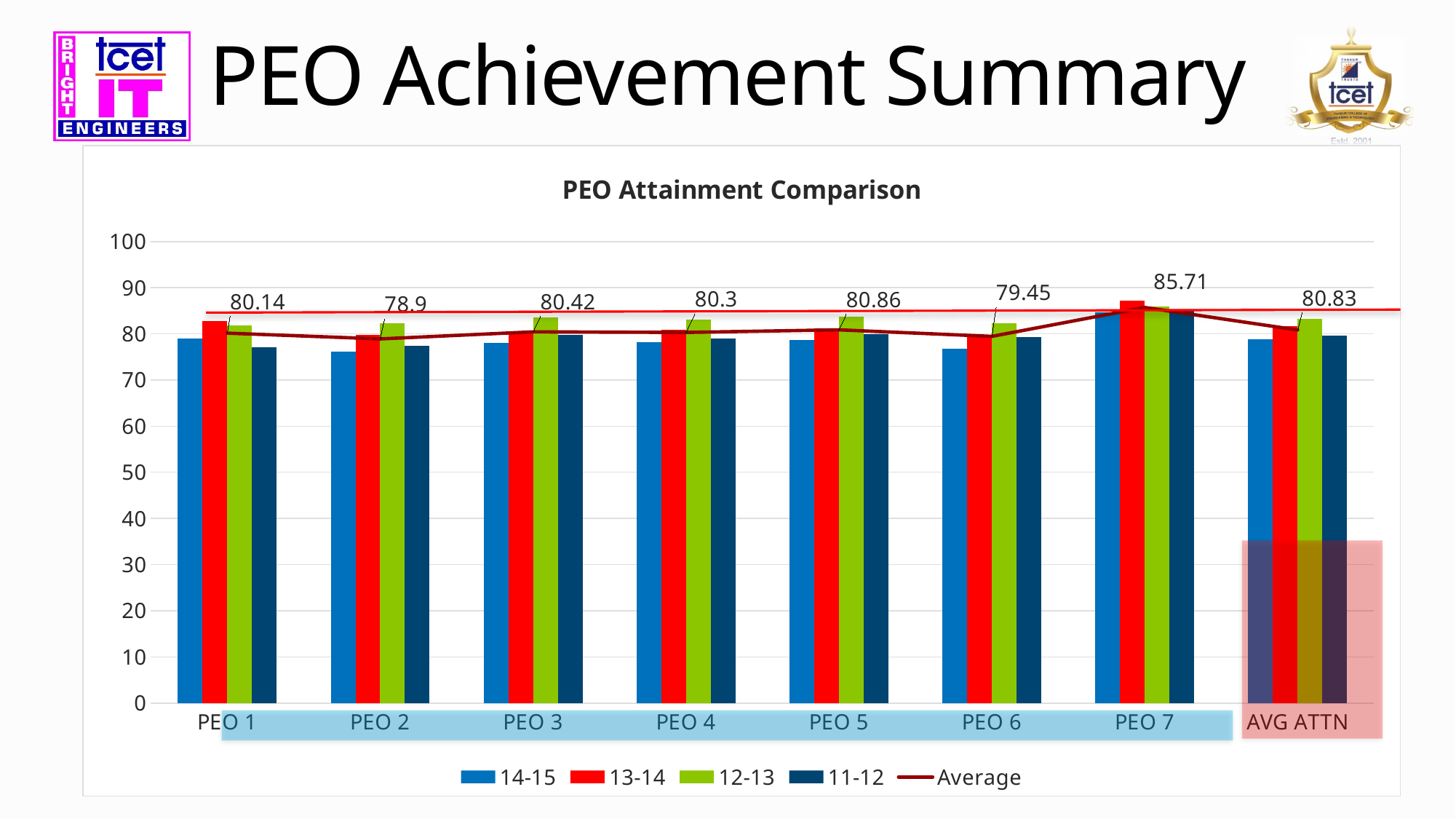
Is the 13-14 value for PEO 7 greater or less than 80? greater What is the title of the chart? PEO Attainment Comparison What is the difference between the Average values for PEO 7 and PEO 2? 6.81 How many series does the legend list? 5 How many categories are shown on the x axis? 8 What is the Average value shown for PEO 1? 80.14 Which category has the lowest Average value? PEO 2 Which category has the highest Average value? PEO 7 What is the Average value shown for PEO 7? 85.71 Which has a larger Average value, PEO 5 or PEO 6? PEO 5 Is the 14-15 value for PEO 2 greater or less than 80? less What is the Average value shown for AVG ATTN? 80.83